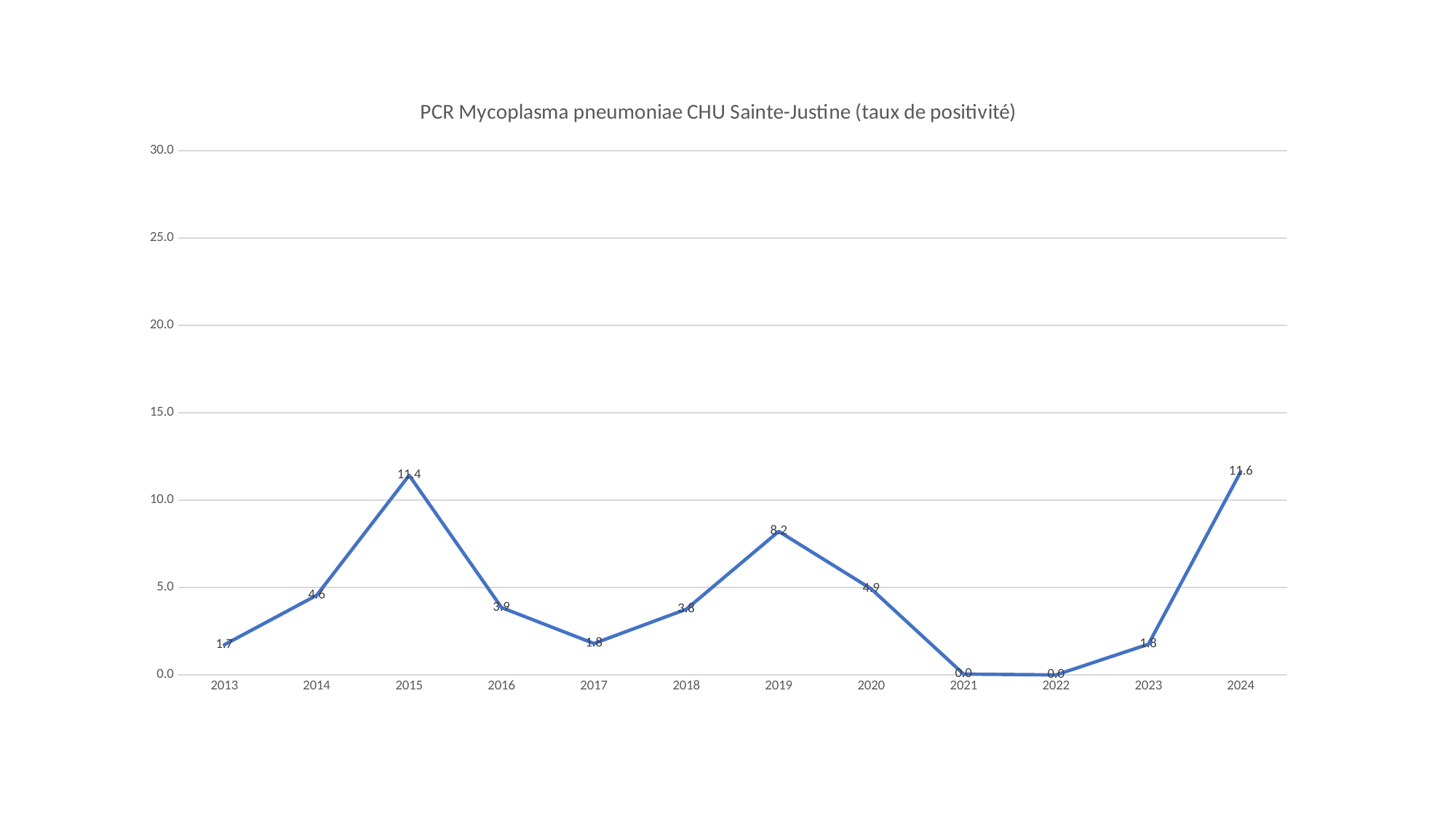
What is the value for 2015? 11.4 What type of chart is shown on the slide? line chart What is the difference between the values for 2024 and 2015? 0.2 What is the value for 2013? 1.7 What is the value for 2019? 8.2 How many years are plotted on the x axis? 12 What is the value for 2021? 0.0 What is the difference between the values for 2019 and 2020? 3.3 Which is larger, the value for 2014 or the value for 2020? 2020 What is the value for 2024? 11.6 Which year has the highest value? 2024 What is the title of the chart? PCR Mycoplasma pneumoniae CHU Sainte-Justine (taux de positivité)